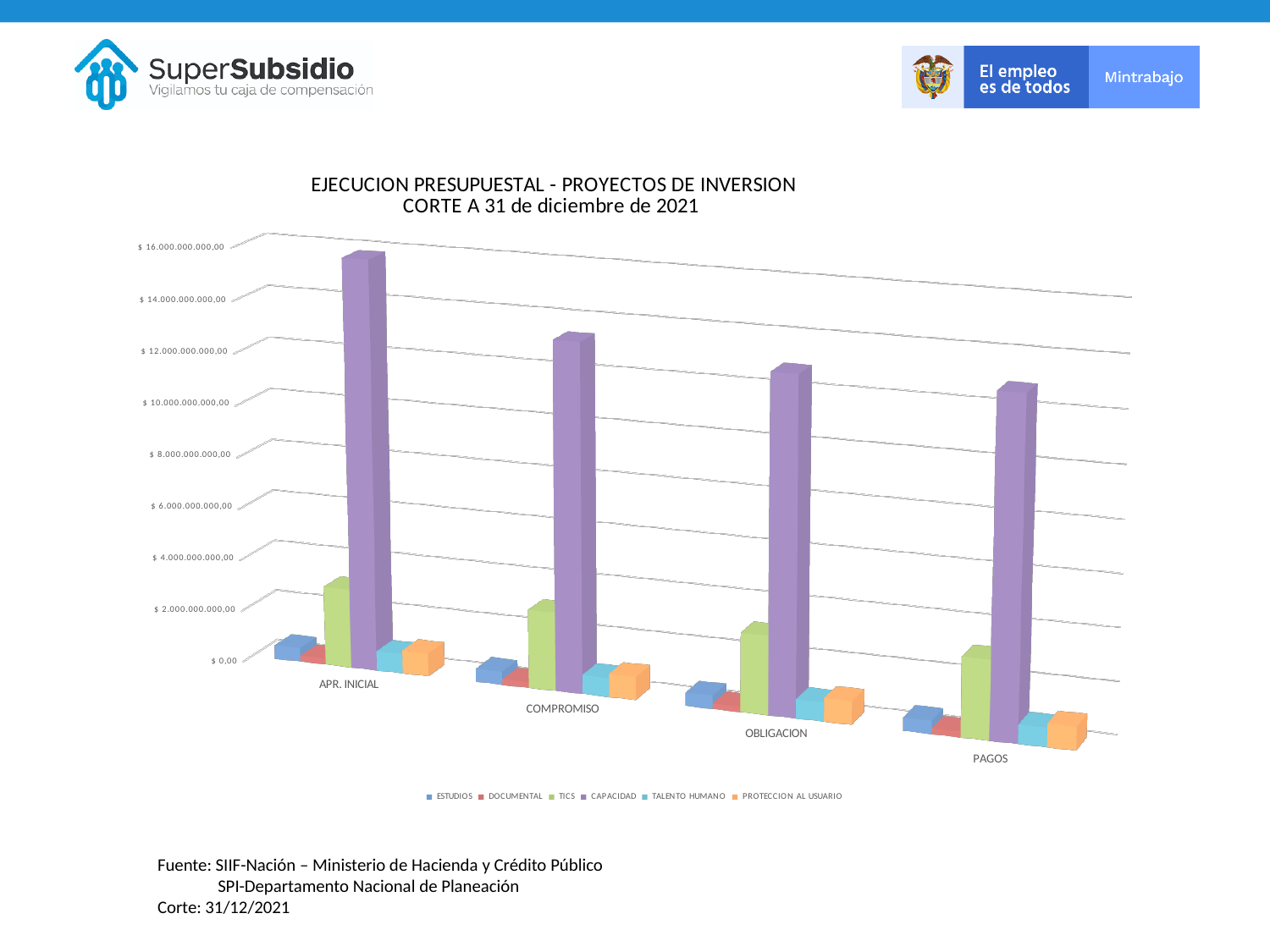
Is the CAPACIDAD value for PAGOS greater or less than $ 8.000.000.000,00? greater How many series does the chart's legend list? 6 Is the TICS value for APR. INICIAL greater or less than $ 4.000.000.000,00? less Which series has the highest value in the APR. INICIAL category? CAPACIDAD What kind of chart is shown on the slide? bar chart How many categories are shown along the x axis of the chart? 4 Does the CAPACIDAD series rise or fall from APR. INICIAL to PAGOS? fall Which is larger: the CAPACIDAD value for APR. INICIAL or the CAPACIDAD value for PAGOS? APR. INICIAL Which series has the highest value in the PAGOS category? CAPACIDAD Which is larger in the APR. INICIAL category: TICS or ESTUDIOS? TICS Is the CAPACIDAD value for APR. INICIAL greater or less than $ 14.000.000.000,00? greater What is the title of the chart? EJECUCION PRESUPUESTAL - PROYECTOS DE INVERSION CORTE A 31 de diciembre de 2021